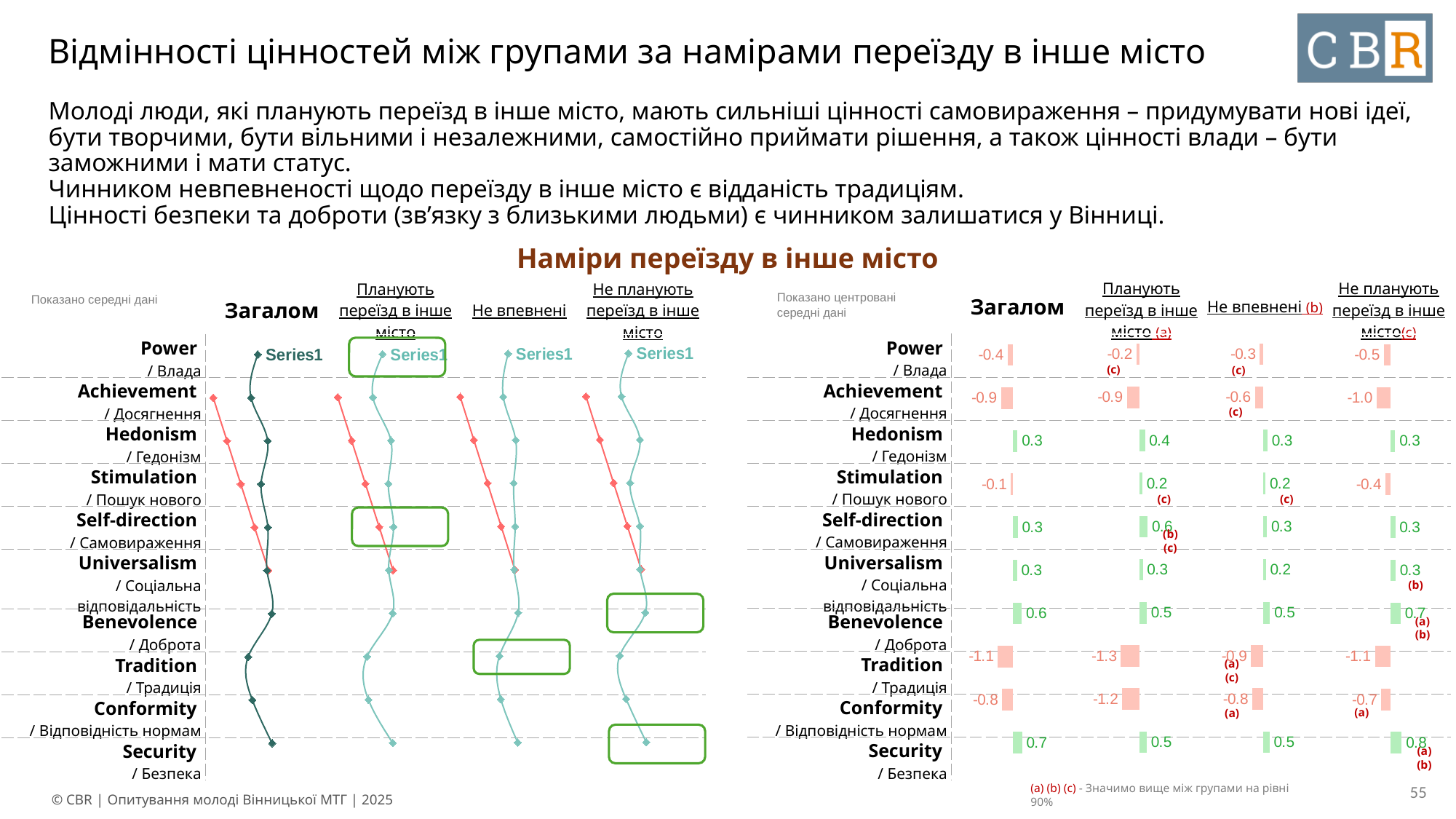
In the right-hand bar charts, which value category has the lowest value in the 'Загалом' column? Tradition In the right-hand bar charts, which value category has the highest value in the 'Не планують переїзд в інше місто' column? Security In the right-hand bar charts, what is the value for Self-direction in the 'Планують переїзд в інше місто' column? 0.6 In the right-hand bar charts, what is the value for Tradition in the 'Планують переїзд в інше місто' column? -1.3 In the right-hand bar charts, which is larger for Achievement: the 'Не впевнені' value or the 'Не планують переїзд в інше місто' value? Не впевнені In the right-hand bar charts, what is the value for Stimulation in the 'Не планують переїзд в інше місто' column? -0.4 In the right-hand bar charts, what is the difference between the Conformity values for 'Планують переїзд в інше місто' (-1.2) and 'Не планують переїзд в інше місто' (-0.7)? 0.5 In the right-hand bar charts, which is larger for Benevolence: the 'Загалом' value or the 'Не планують переїзд в інше місто' value? Не планують переїзд в інше місто How many value categories are plotted in each chart on the slide? 10 In the right-hand bar charts (centered mean data), what is the value for Security in the 'Загалом' column? 0.7 What kind of chart is used in the left-hand section of the slide (Показано середні дані)? Line chart What is the title shown above the charts on the slide? Наміри переїзду в інше місто